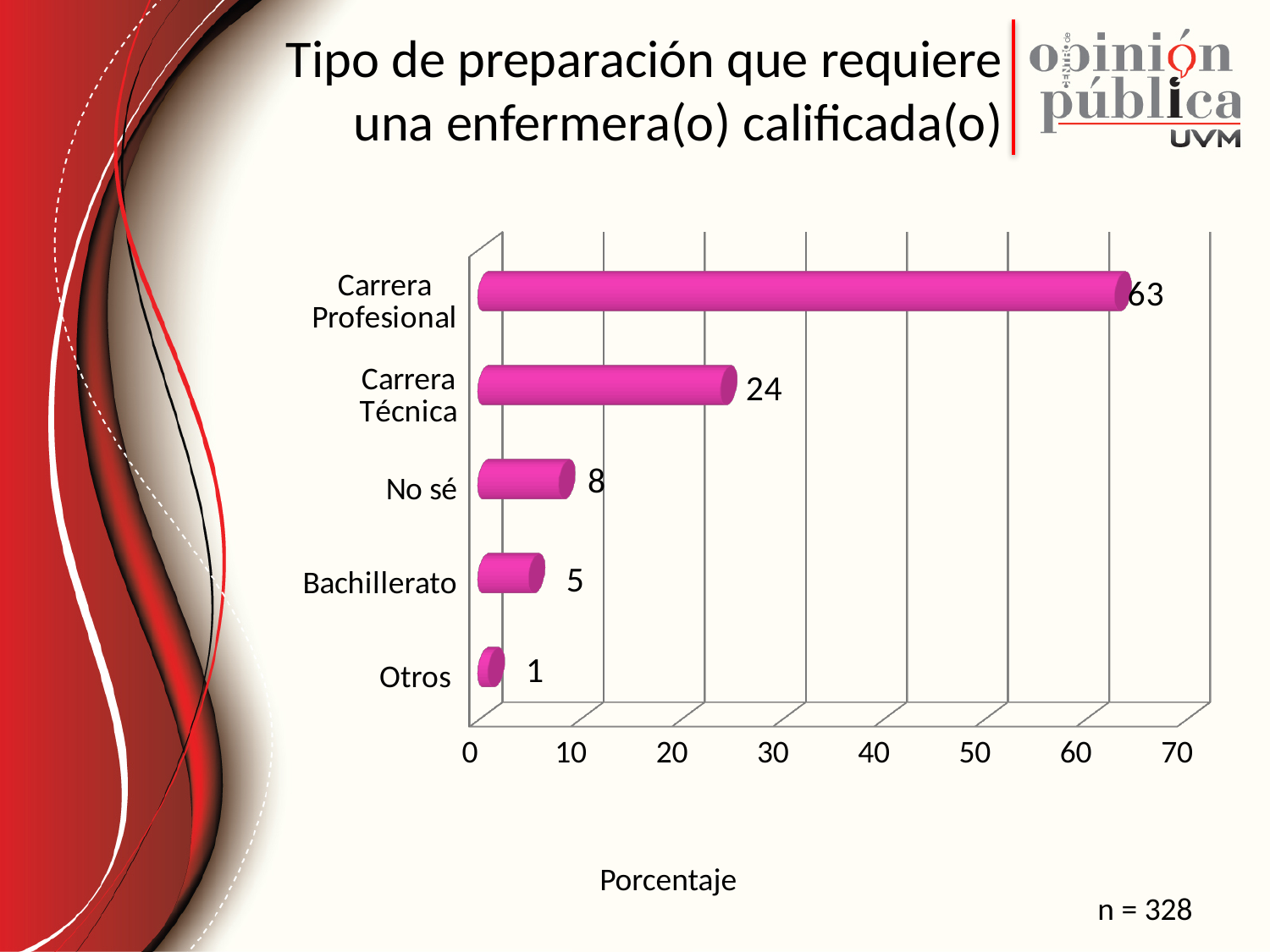
What kind of chart is shown on the slide? Bar chart What is the value for Carrera Profesional? 63 What is the value for Bachillerato? 5 What is the value for No sé? 8 What is the value for Carrera Técnica? 24 Is the value for Carrera Profesional greater or less than 60? greater How many categories are shown in the chart? 5 Which is larger, the value for No sé or the value for Bachillerato? No sé What is the difference between the values for Carrera Profesional and Carrera Técnica? 39 Which category has the lowest value? Otros Which category has the highest value? Carrera Profesional What is the label of the horizontal axis? Porcentaje